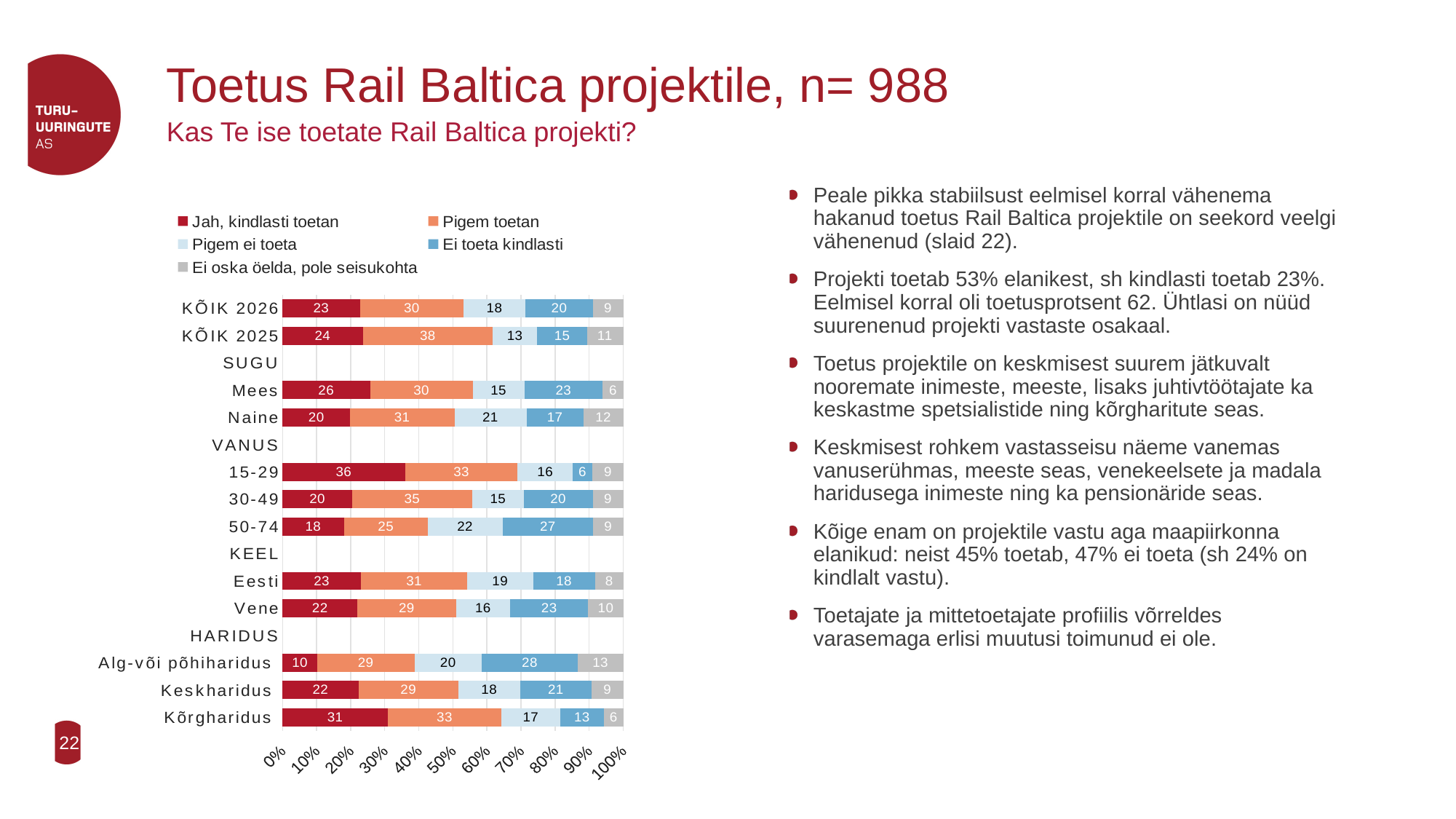
What is the value of "Pigem toetan" for KÕIK 2025? 38 Which category has the highest value for "Jah, kindlasti toetan"? 15-29 Which has a larger "Jah, kindlasti toetan" value, Mees or Naine? Mees What is the value of "Ei oska öelda, pole seisukohta" for Alg-või põhiharidus? 13 What is the value of "Ei toeta kindlasti" for the 50-74 age group? 27 By how much does the "Pigem toetan" value for KÕIK 2025 exceed that for KÕIK 2026? 8 What kind of chart is shown on the slide? Stacked bar chart What is the value of "Jah, kindlasti toetan" for the 15-29 age group? 36 Which category has the lowest value for "Jah, kindlasti toetan"? Alg-või põhiharidus How many categories have bars plotted in the chart? 12 Which category has the highest value for "Ei toeta kindlasti"? Alg-või põhiharidus How many series does the legend list? 5